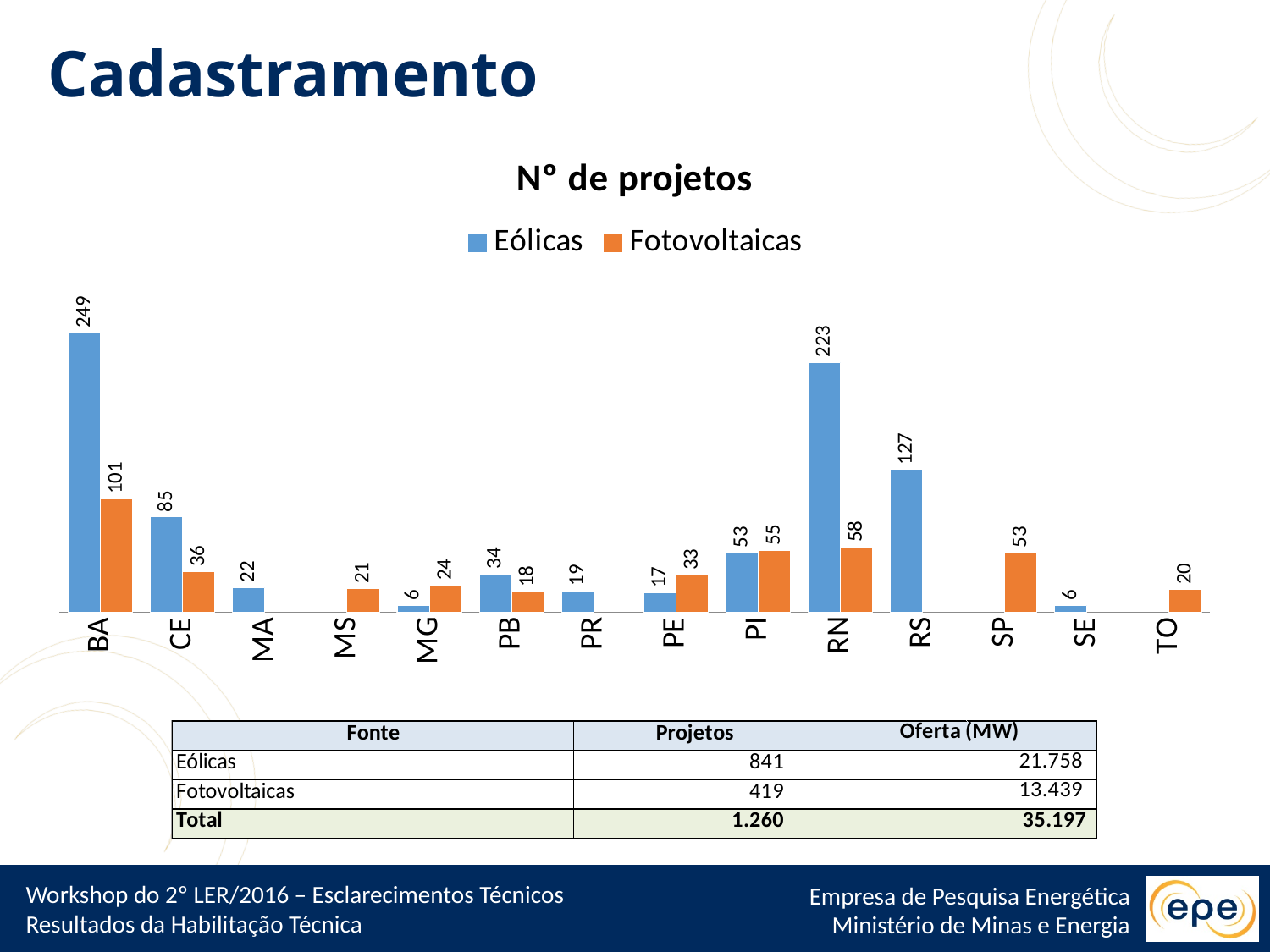
What is the value for Eólicas in RS? 127 How many series does the legend list? 2 What is the value for Fotovoltaicas in SP? 53 What is the value for Eólicas in BA? 249 In PE, which is larger: Eólicas or Fotovoltaicas? Fotovoltaicas Which state has the highest value for Eólicas? BA What is the value for Fotovoltaicas in RN? 58 How many states are shown on the x axis of the chart? 14 What is the difference between Eólicas and Fotovoltaicas in RN? 165 What kind of chart is shown on the slide? bar chart What is the difference between Eólicas and Fotovoltaicas in BA? 148 Which state has the lowest value for Fotovoltaicas? PB